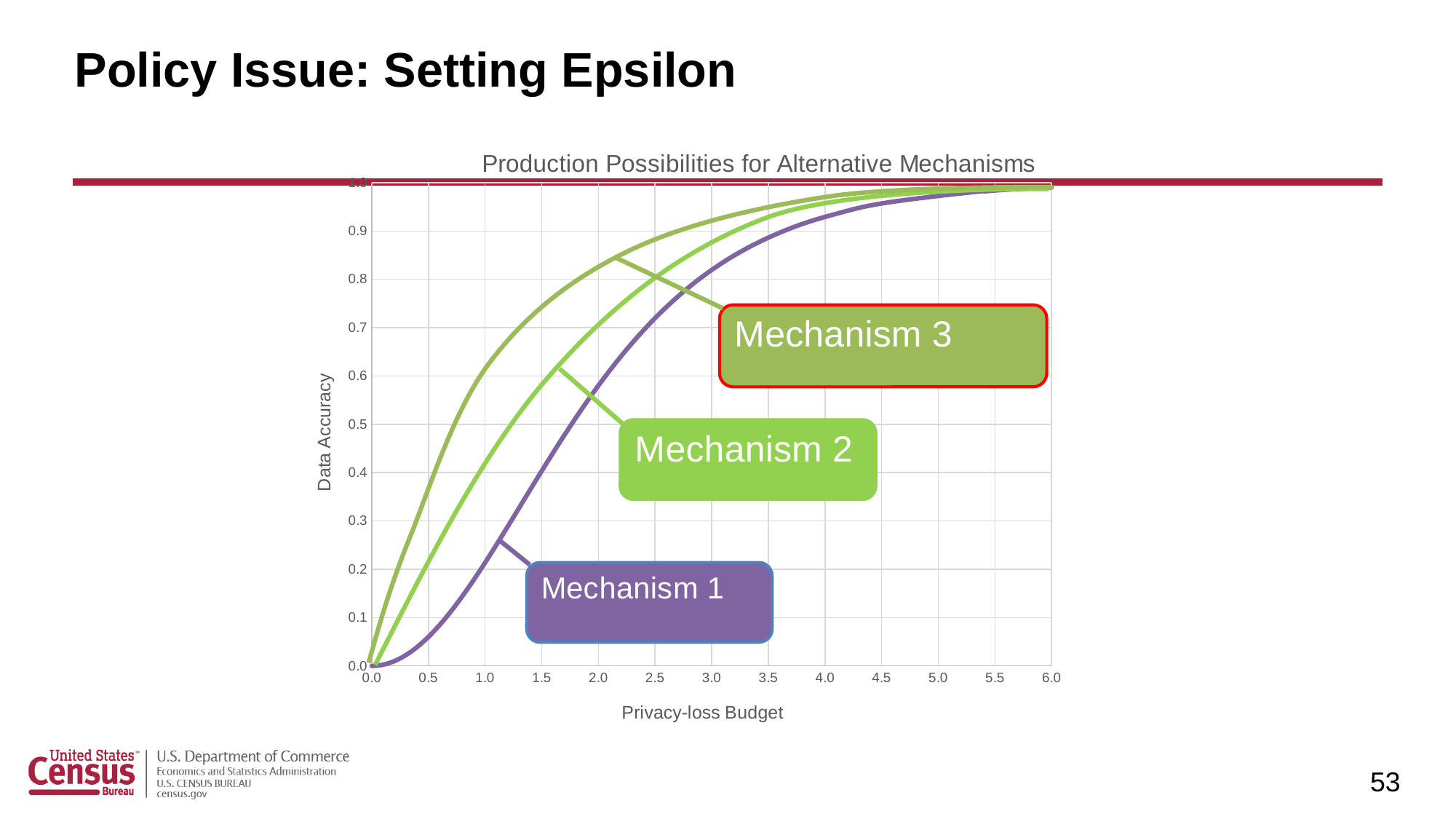
At a Privacy-loss Budget of 2.0, is the Data Accuracy for Mechanism 2 greater or less than 0.5? greater How many mechanisms (curves) are plotted on the chart? 3 At a Privacy-loss Budget of 1.5, which curve has the highest Data Accuracy? Mechanism 3 What is the label of the x axis? Privacy-loss Budget Does Data Accuracy rise or fall as the Privacy-loss Budget increases for Mechanism 1? rise At a Privacy-loss Budget of 1.0, is the Data Accuracy for Mechanism 3 greater or less than 0.5? greater What is the title of the chart? Production Possibilities for Alternative Mechanisms What kind of chart is shown on the slide? line chart At a Privacy-loss Budget of 1.0, is the Data Accuracy for Mechanism 1 greater or less than 0.3? less At a Privacy-loss Budget of 2.0, which curve has the lowest Data Accuracy? Mechanism 1 At a Privacy-loss Budget of 1.0, which curve has the higher Data Accuracy, Mechanism 3 or Mechanism 1? Mechanism 3 What is the Data Accuracy of Mechanism 1 at a Privacy-loss Budget of 0.0? 0.0